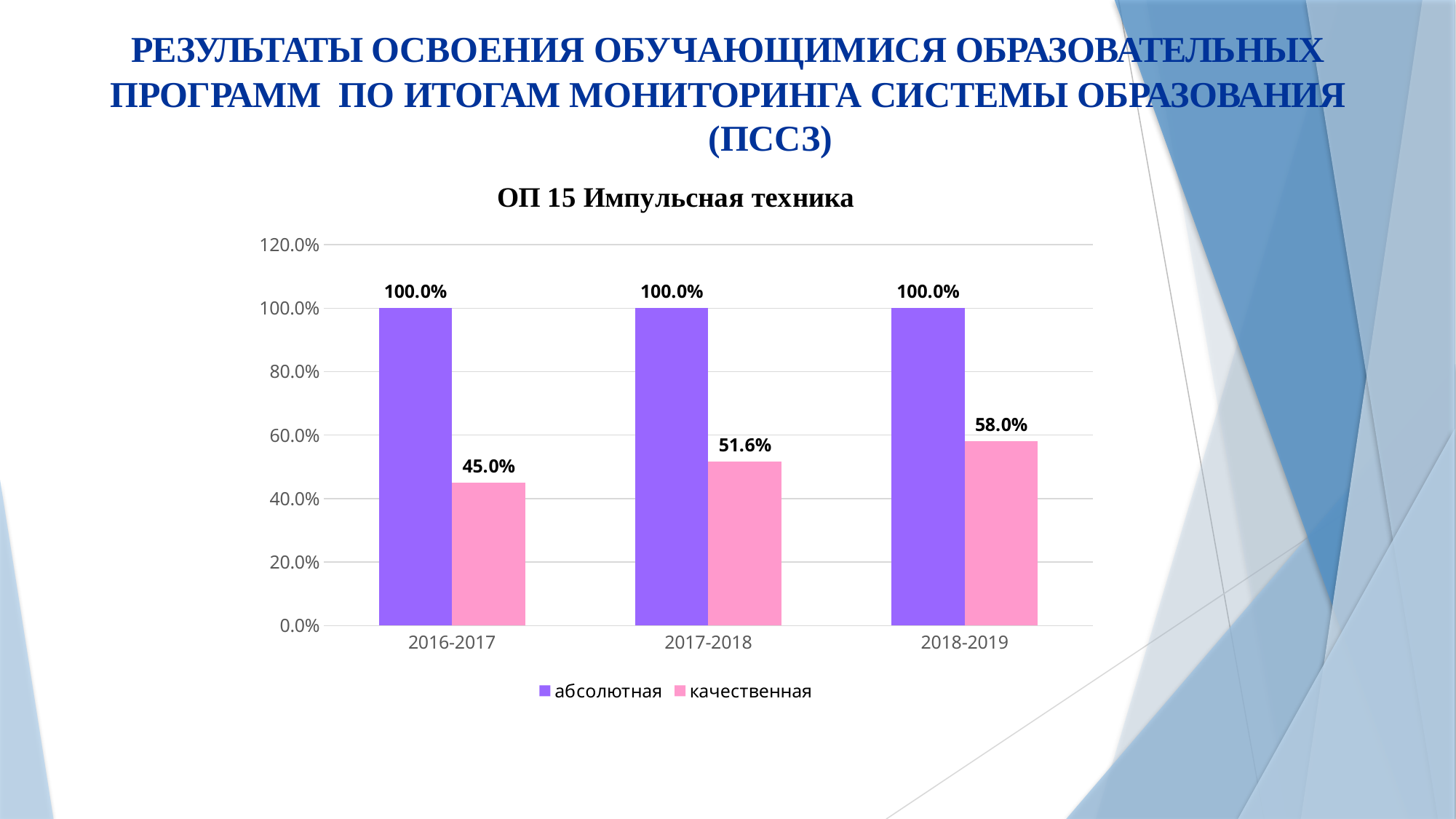
How many year categories are shown on the x axis? 3 Does качественная rise or fall from 2016-2017 to 2018-2019? Rises What is the value of качественная for 2018-2019? 58.0% How many series does the legend list? 2 Which is larger: качественная in 2017-2018 or качественная in 2016-2017? 2017-2018 What is the difference between качественная in 2018-2019 and 2016-2017? 13.0% What is the value of качественная for 2016-2017? 45.0% What kind of chart is shown? Bar chart What is the value of абсолютная for 2017-2018? 100.0% In which year is качественная highest? 2018-2019 In which year is качественная lowest? 2016-2017 What is the value of качественная for 2017-2018? 51.6%